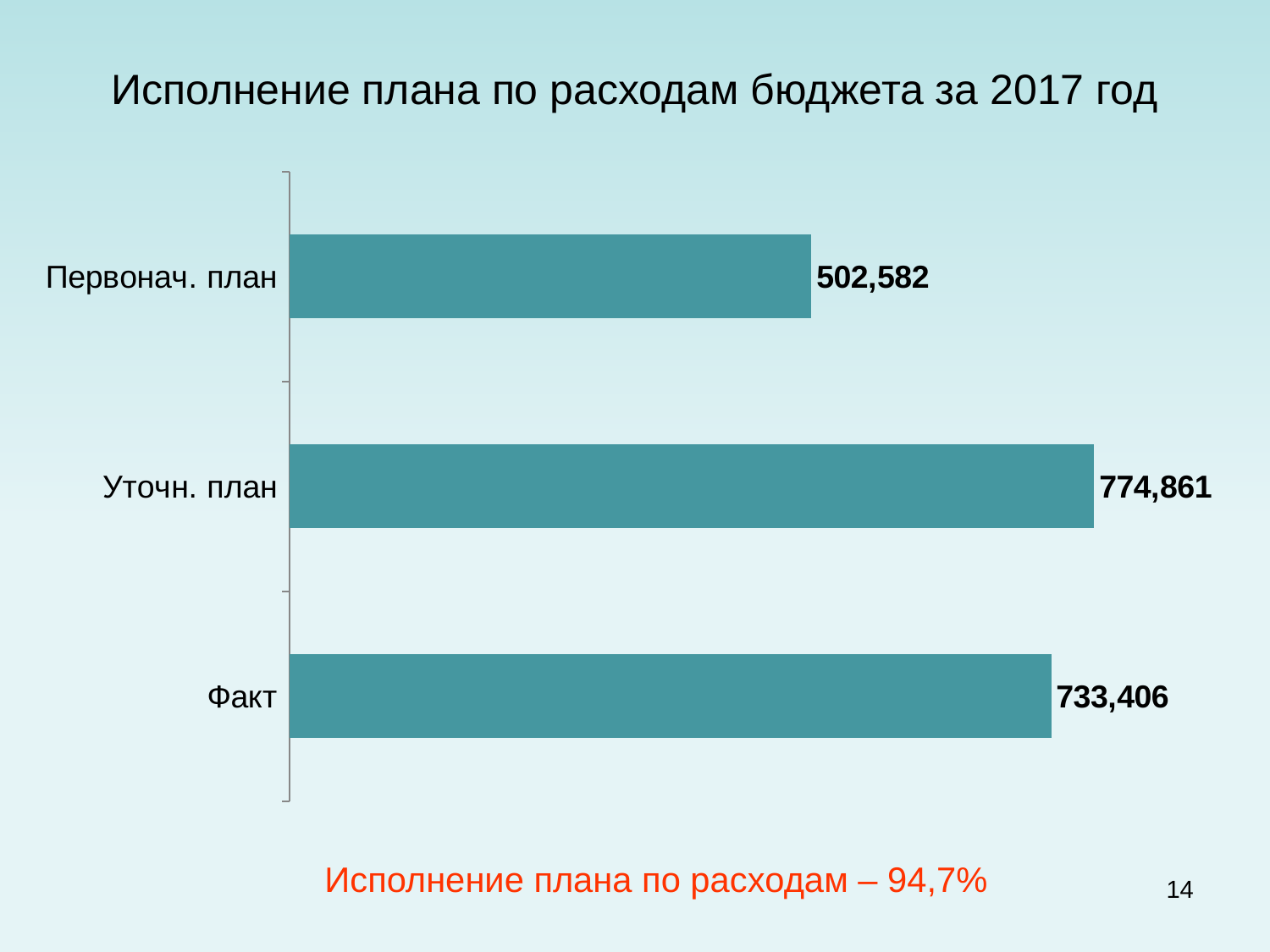
What is the difference between Уточн. план and Факт? 41,455 How many categories are shown in the chart? 3 What is the difference between Уточн. план and Первонач. план? 272,279 What is the title of the chart on the slide? Исполнение плана по расходам бюджета за 2017 год Which category has the highest value? Уточн. план What is the difference between Факт and Первонач. план? 230,824 What is the value for Первонач. план? 502,582 Which is larger, Факт or Первонач. план? Факт What is the value for Факт? 733,406 Which category has the lowest value? Первонач. план What kind of chart is shown on the slide? Bar chart What is the value for Уточн. план? 774,861